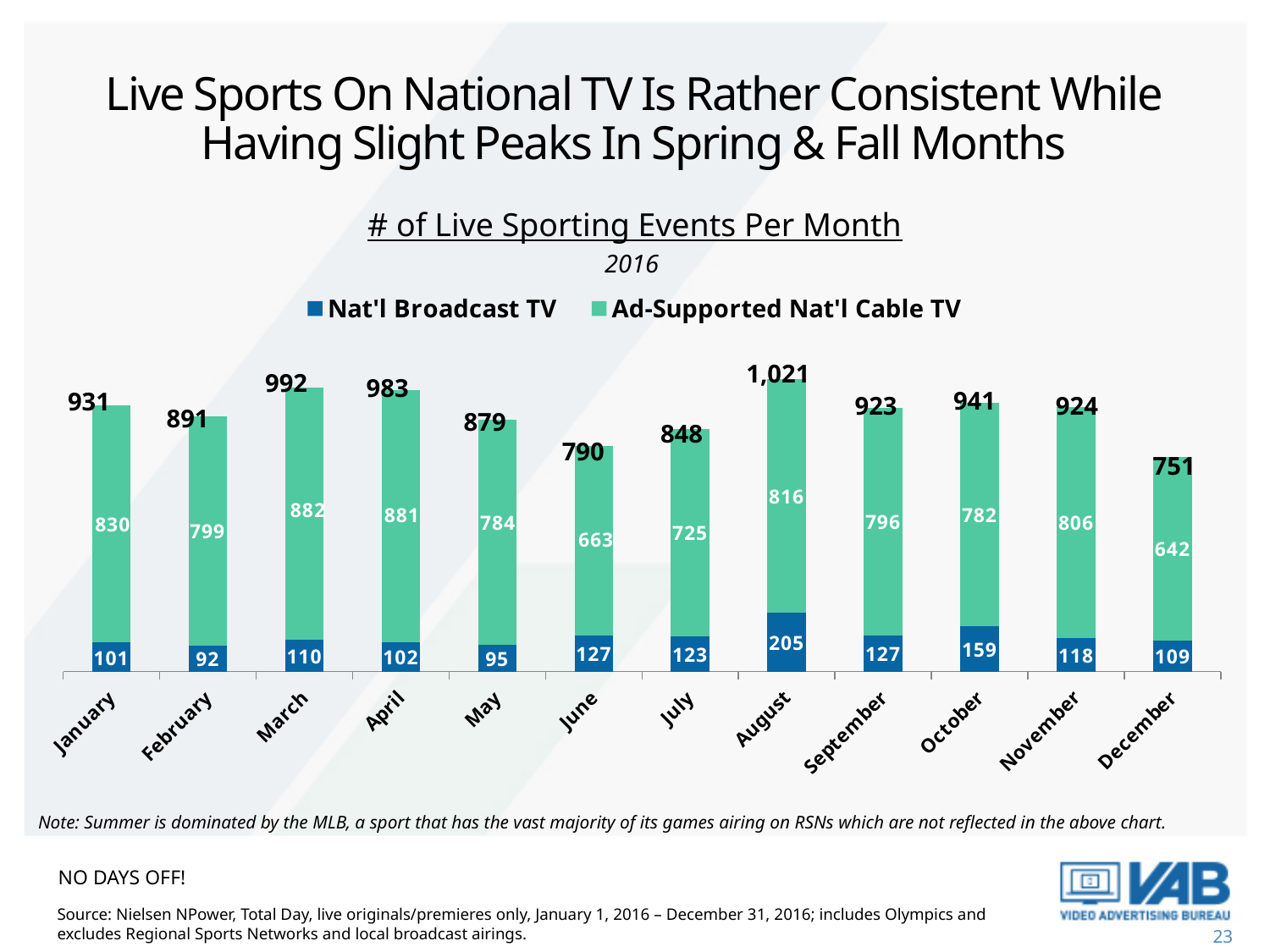
How many months are shown on the x axis? 12 Which is larger, the Nat'l Broadcast TV value for October or for November? October What is the Ad-Supported Nat'l Cable TV value for March? 882 What is the total number of live sporting events shown for December? 751 What kind of chart is shown on the slide? Stacked bar chart What is the title of the chart? # of Live Sporting Events Per Month What is the difference between the total for August and the total for June? 231 Which month has the lowest Ad-Supported Nat'l Cable TV value? December How many series does the legend list? 2 Which month has the lowest Nat'l Broadcast TV value? February Which month has the highest total number of live sporting events? August What is the Nat'l Broadcast TV value for August? 205